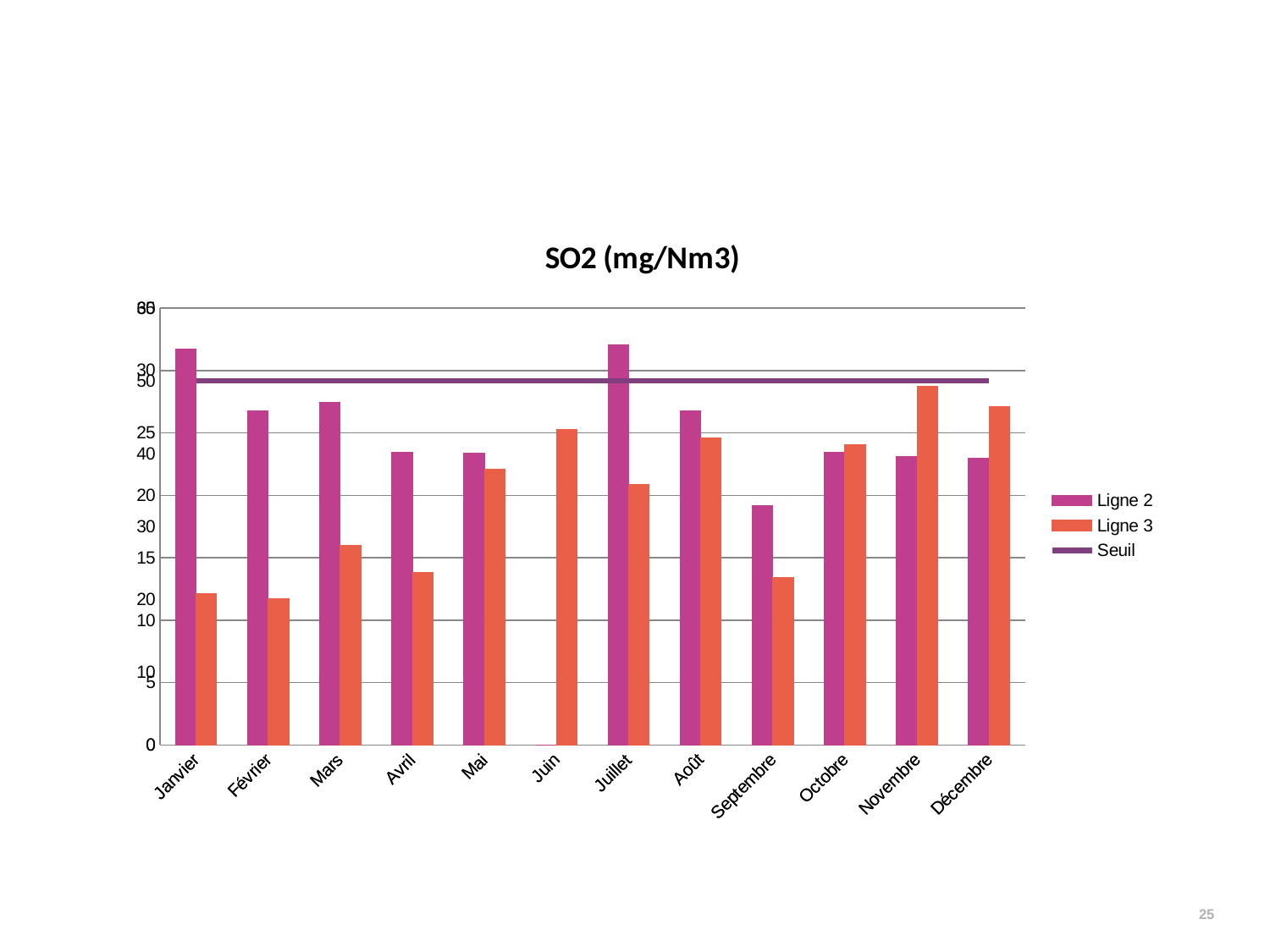
In Janvier, which is larger, Ligne 2 or Ligne 3? Ligne 2 In Juillet, which is larger, Ligne 2 or Ligne 3? Ligne 2 How many months are shown along the x axis? 12 In Mars, which is larger, Ligne 2 or Ligne 3? Ligne 2 What kind of chart is shown on the slide? Bar chart How many series does the legend list? 3 Which month has no visible Ligne 2 bar? Juin Which series is drawn as a horizontal line rather than bars? Seuil What is the title of the chart? SO2 (mg/Nm3) For which month is the Ligne 3 bar the highest? Novembre For which month is the Ligne 2 bar the lowest? Juin